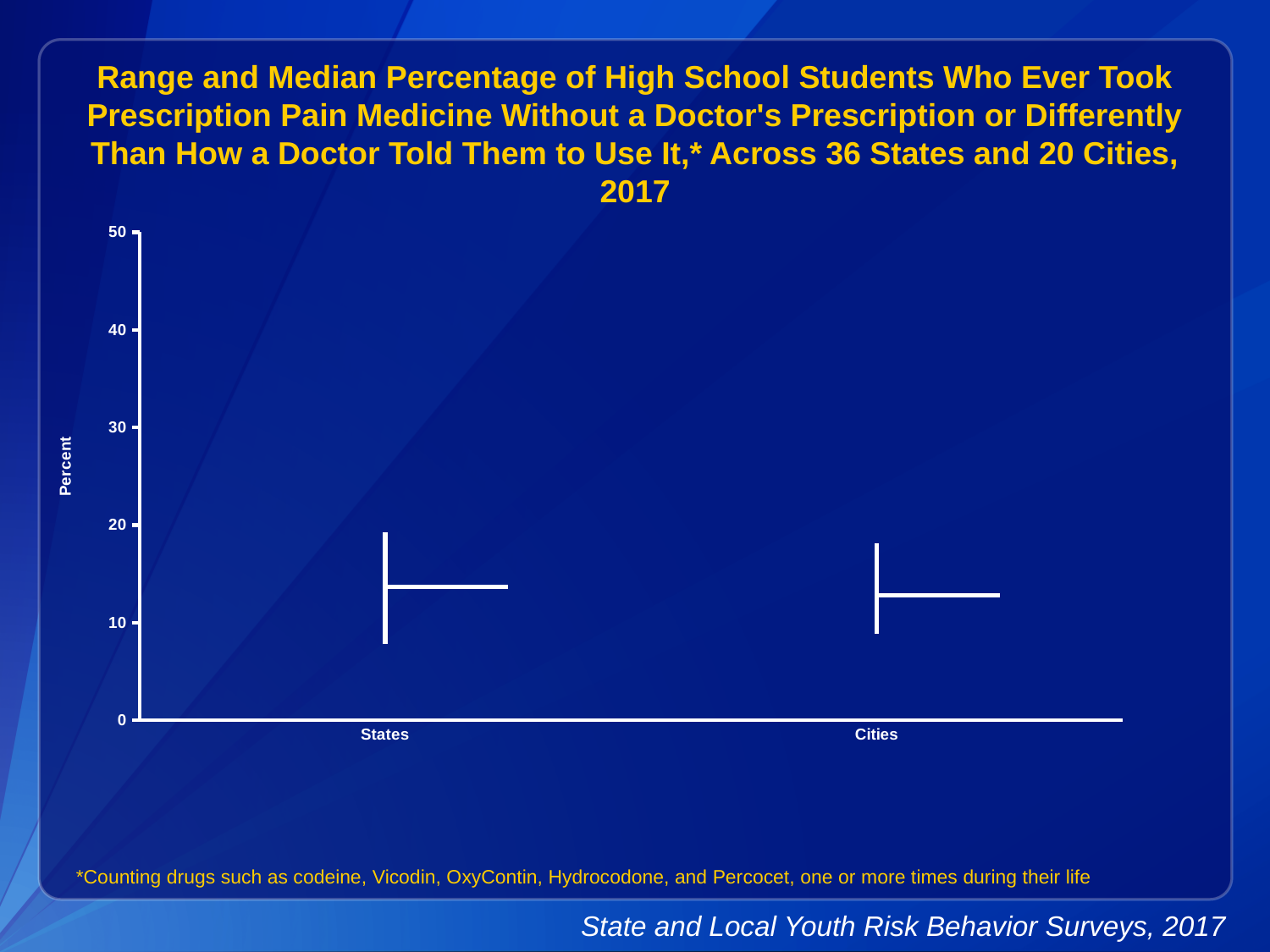
Is the highest value in the range for Cities greater or less than 10? greater Is the median value for States greater or less than 20? less Is the median value for States greater or less than 10? greater How many categories are shown on the x axis of the chart? 2 What is the label on the y axis of the chart? Percent What is the maximum value shown on the y axis of the chart? 50 What are the two categories shown on the x axis? States and Cities